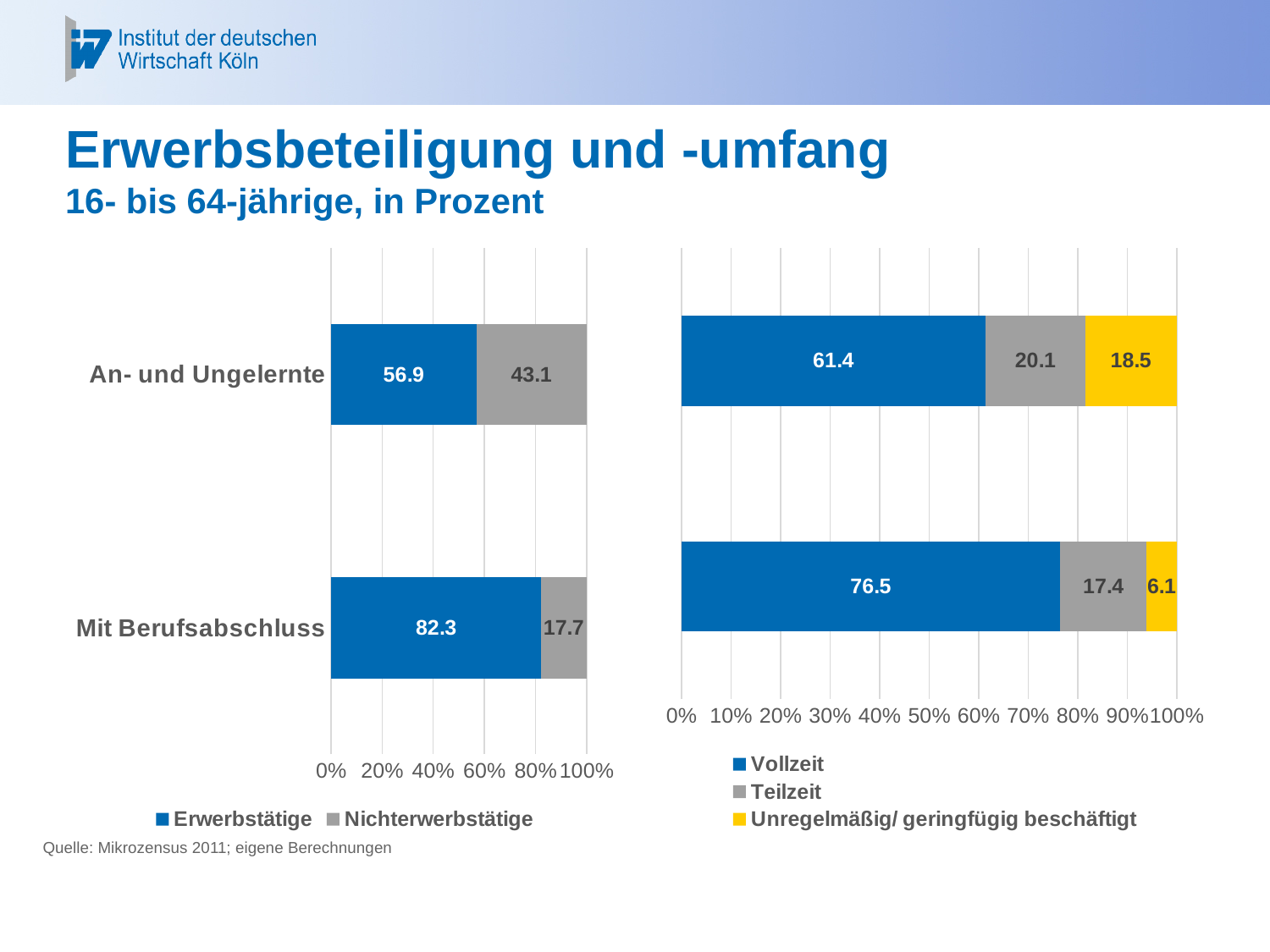
In the left chart, how many series does the legend list? 2 In the left chart, what is the value for Erwerbstätige among An- und Ungelernte? 56.9 In the right chart, what is the Unregelmäßig/ geringfügig beschäftigt value for the bottom bar? 6.1 In the right chart, what is the Teilzeit value for the top bar? 20.1 In the right chart, which bar has the larger Vollzeit value, the top bar or the bottom bar? Bottom bar In the left chart, what is the difference between the Erwerbstätige values for Mit Berufsabschluss and An- und Ungelernte? 25.4 In the left chart, which category has the higher Erwerbstätige value? Mit Berufsabschluss In the right chart, what is the difference between the Unregelmäßig/ geringfügig beschäftigt values of the top and bottom bars? 12.4 In the right chart, what is the Vollzeit value for the top bar? 61.4 In the left chart, what is the value for Nichterwerbstätige among Mit Berufsabschluss? 17.7 In the right chart, how many series does the legend list? 3 What kind of chart is the left chart? Stacked bar chart